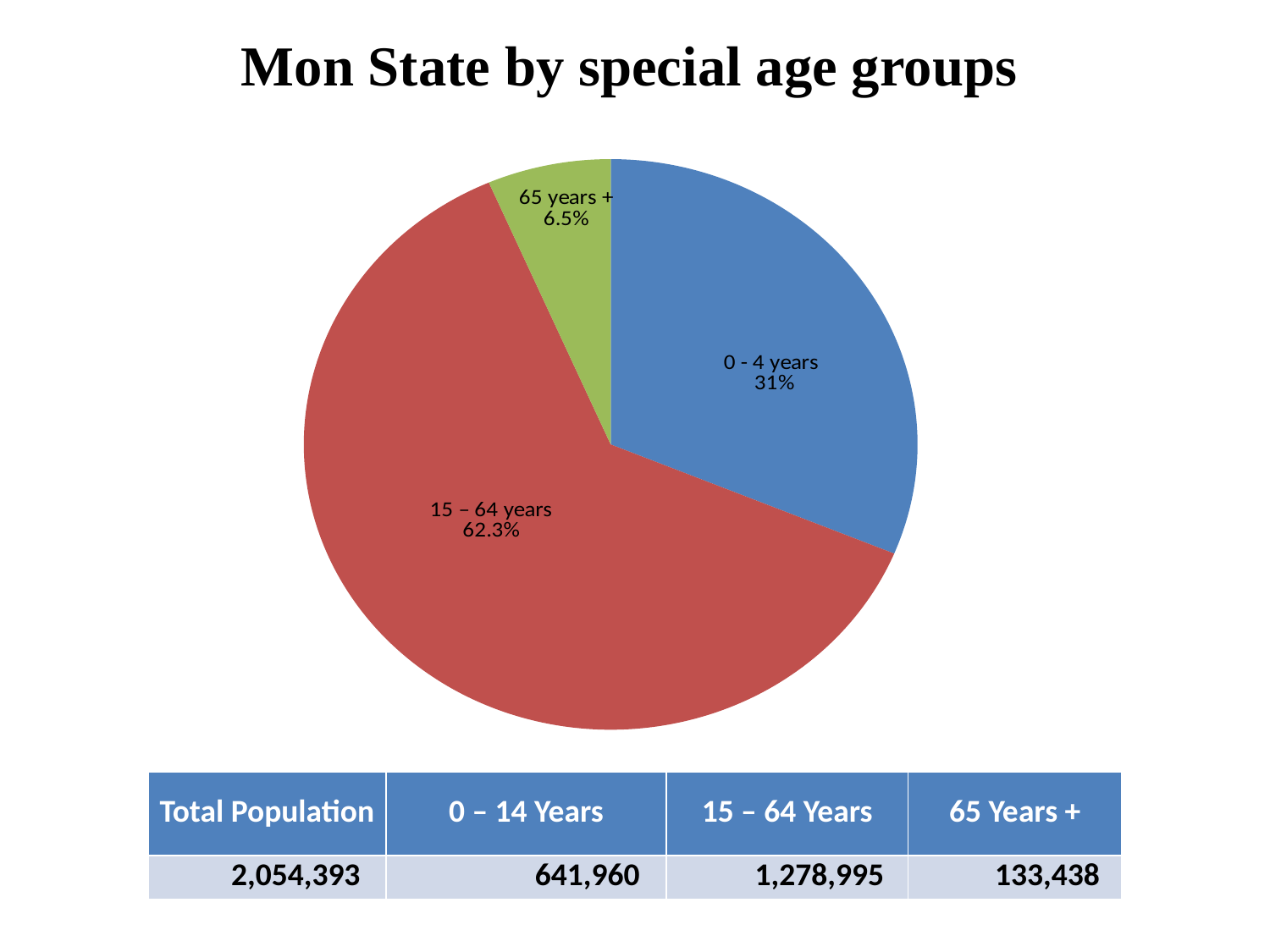
What is the title of the slide's chart? Mon State by special age groups Which age group has the smallest slice of the pie? 65 years + Is the share for the 65 years + slice greater or less than 10%? less What share of the pie does the 65 years + slice represent? 6.5% Which slice is larger, 0 - 4 years or 65 years +? 0 - 4 years What percentage is shown for the 0 - 4 years slice? 31% What share of the pie does the 15 – 64 years slice represent? 62.3% Which age group has the largest slice of the pie? 15 – 64 years How many slices does the pie chart have? 3 What kind of chart is shown on the slide? pie chart What colour is the 15 – 64 years slice? red What is the difference in percentage points between the 15 – 64 years slice and the 0 - 4 years slice? 31.3